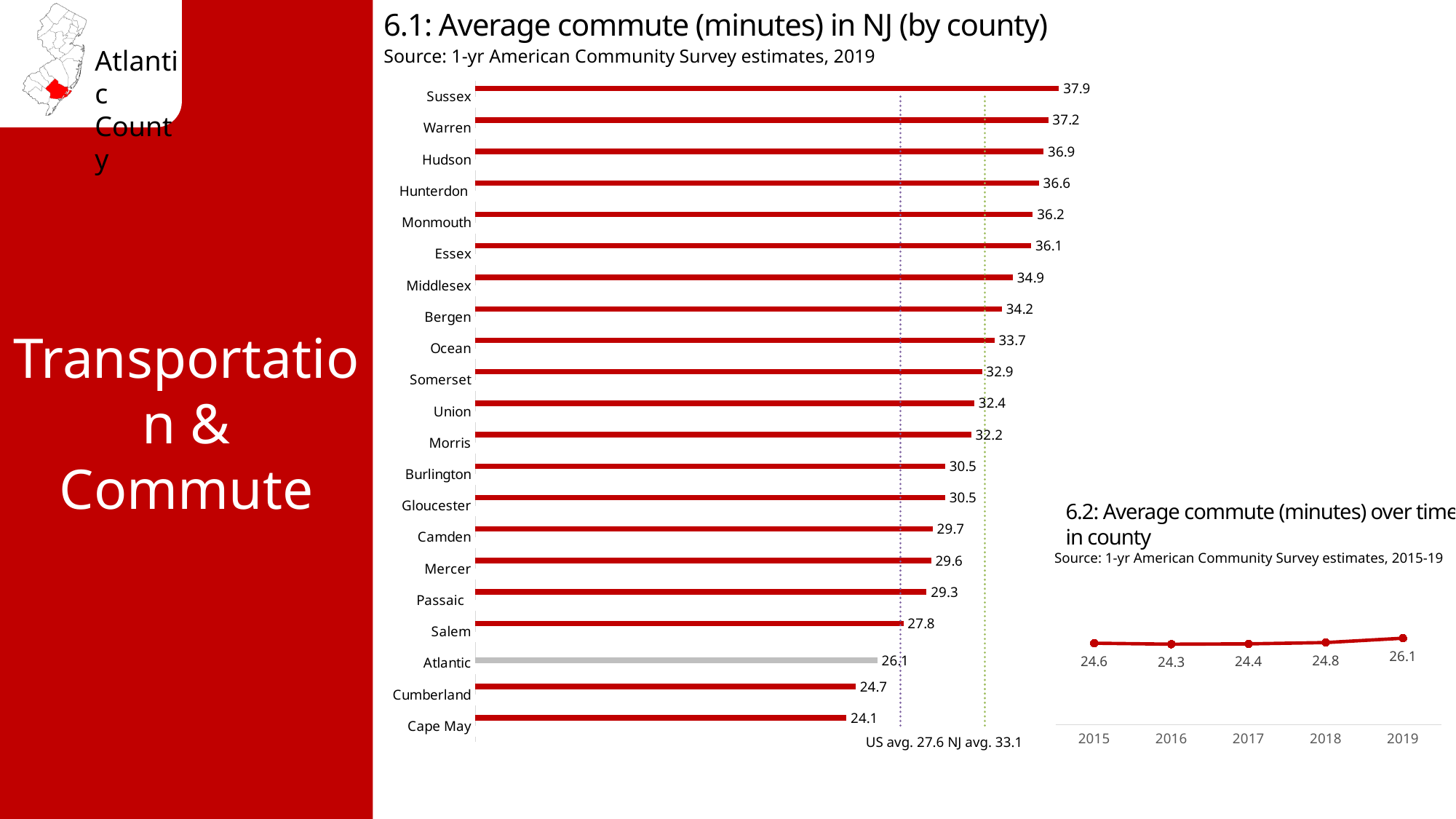
In the chart '6.2: Average commute (minutes) over time in county', what is the difference between the 2019 and 2015 values? 1.5 In the chart '6.2: Average commute (minutes) over time in county', what is the value for 2017? 24.4 In the chart '6.1: Average commute (minutes) in NJ (by county)', what is the difference between the values for Sussex and Cape May? 13.8 What kind of chart is '6.1: Average commute (minutes) in NJ (by county)'? Bar chart In the chart '6.1: Average commute (minutes) in NJ (by county)', what is the value for Atlantic? 26.1 In the chart '6.1: Average commute (minutes) in NJ (by county)', which is larger, the value for Camden or the value for Mercer? Camden In the chart '6.1: Average commute (minutes) in NJ (by county)', how many counties are shown? 21 In the chart '6.1: Average commute (minutes) in NJ (by county)', what is the value for Hudson? 36.9 In the chart '6.2: Average commute (minutes) over time in county', which year has the lowest value? 2016 In the chart '6.1: Average commute (minutes) in NJ (by county)', what NJ average is noted at the bottom of the chart? 33.1 In the chart '6.1: Average commute (minutes) in NJ (by county)', which county has the lowest average commute? Cape May In the chart '6.1: Average commute (minutes) in NJ (by county)', which county has the highest average commute? Sussex